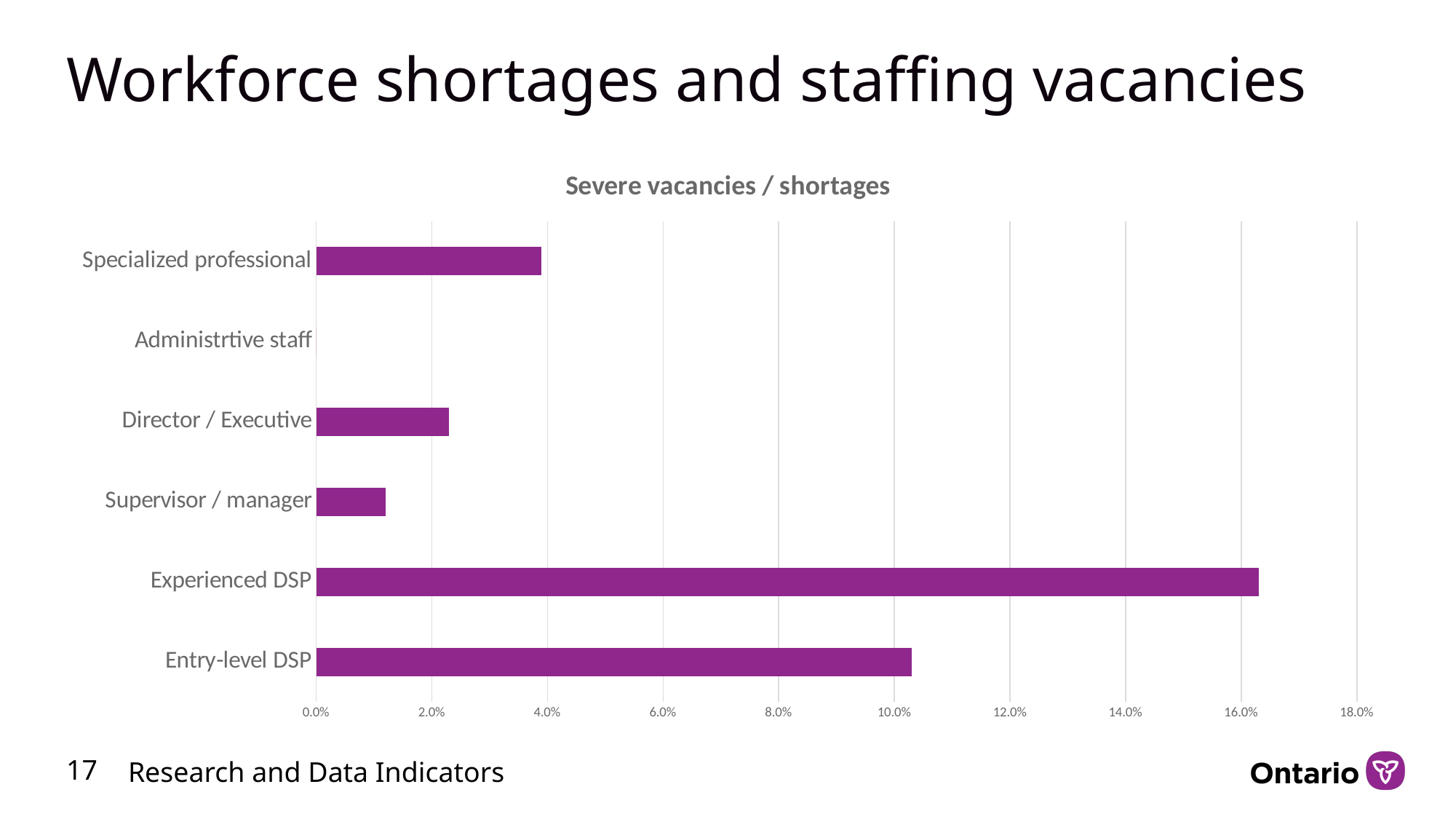
Which category has the highest value? Experienced DSP Is the value for Entry-level DSP greater or less than 10.0%? greater Which is larger, the value for Director / Executive or the value for Supervisor / manager? Director / Executive Is the value for Experienced DSP greater or less than 16.0%? greater Is the value for Director / Executive greater or less than 2.0%? greater Which is larger, the value for Entry-level DSP or the value for Specialized professional? Entry-level DSP Which category has the lowest value? Administrtive staff How many categories are shown on the chart? 6 What is the title of the chart? Severe vacancies / shortages What kind of chart is shown on the slide? Bar chart